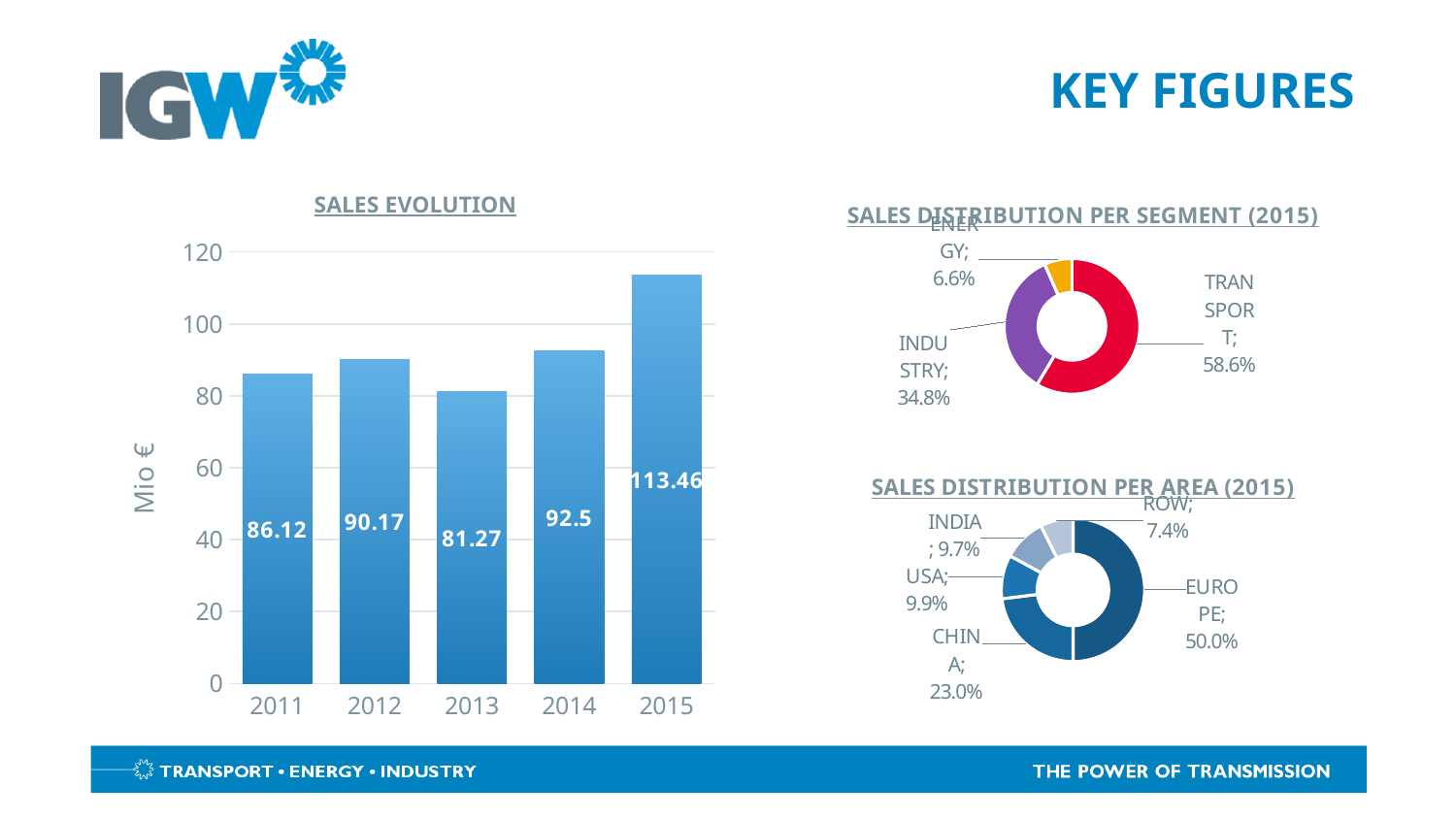
In the Sales Evolution chart, which year had higher sales, 2011 or 2012? 2012 In the Sales Evolution chart, what was the sales value for 2013? 81.27 In the Sales Distribution per Area (2015) chart, what share does China have? 23.0% How many areas are shown in the Sales Distribution per Area (2015) chart? 5 In the Sales Distribution per Segment (2015) chart, what share does Transport have? 58.6% What type of chart is the Sales Evolution chart? Bar chart In the Sales Evolution chart, what is the difference between the 2015 and 2014 sales values? 20.96 In the Sales Evolution chart, which year had the lowest sales? 2013 In the Sales Evolution chart, what was the sales value for 2015? 113.46 In the Sales Distribution per Segment (2015) chart, which segment has the smallest share? Energy How many years are shown in the Sales Evolution chart? 5 In the Sales Evolution chart, which year had the highest sales? 2015